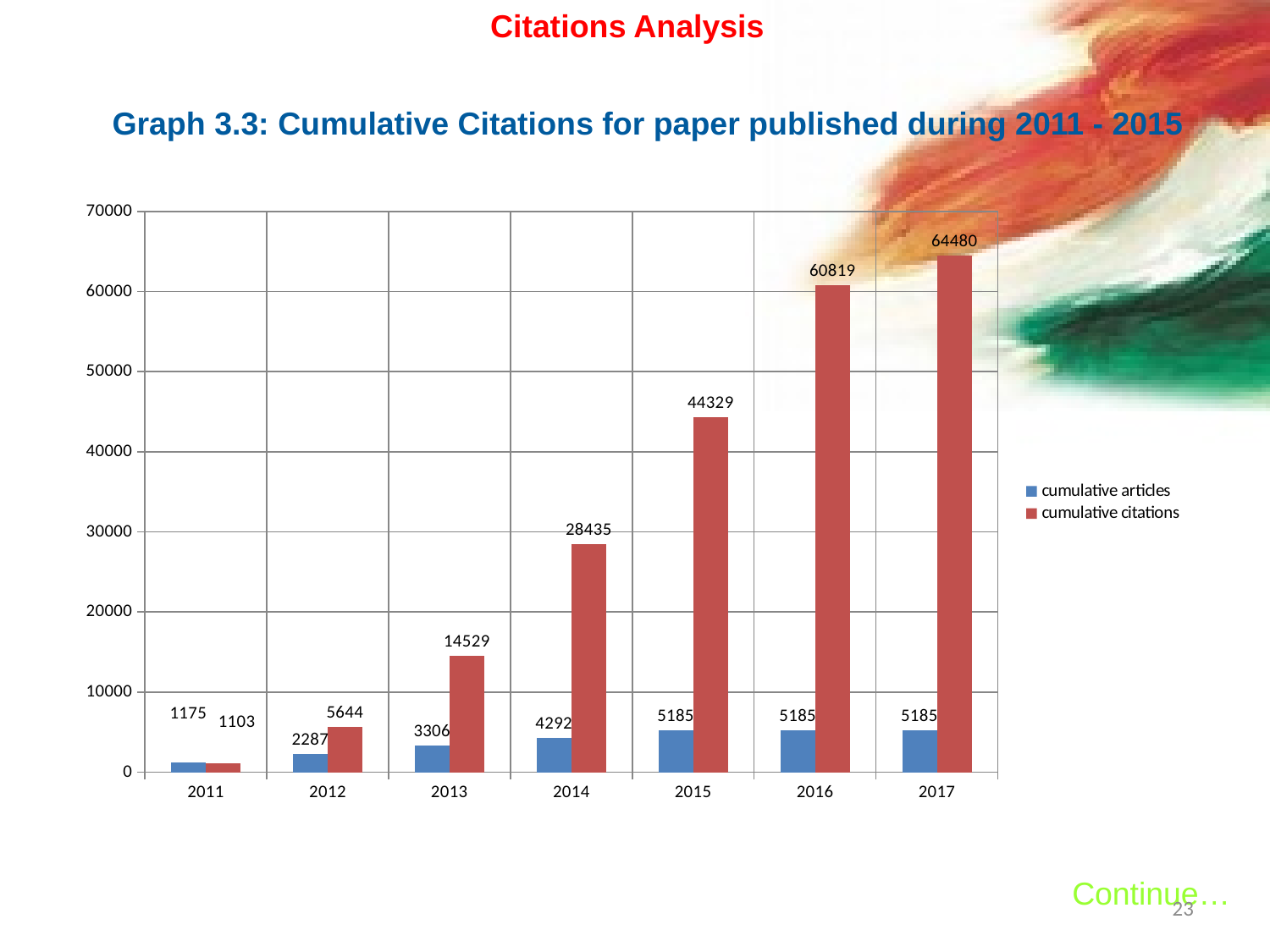
Which year has the lowest cumulative citations? 2011 What is the value of cumulative citations for 2017? 64480 Is the value of cumulative citations for 2015 greater or less than 40000? greater What is the difference between cumulative citations in 2016 and 2015? 16490 How many years are shown on the x axis? 7 Which year has the highest cumulative citations? 2017 What is the value of cumulative articles for 2013? 3306 How many series does the legend list? 2 What is the value of cumulative citations for 2014? 28435 What kind of chart is shown on the slide? bar chart Which is larger in 2011: cumulative articles or cumulative citations? cumulative articles Do cumulative citations rise or fall from 2011 to 2017? rise